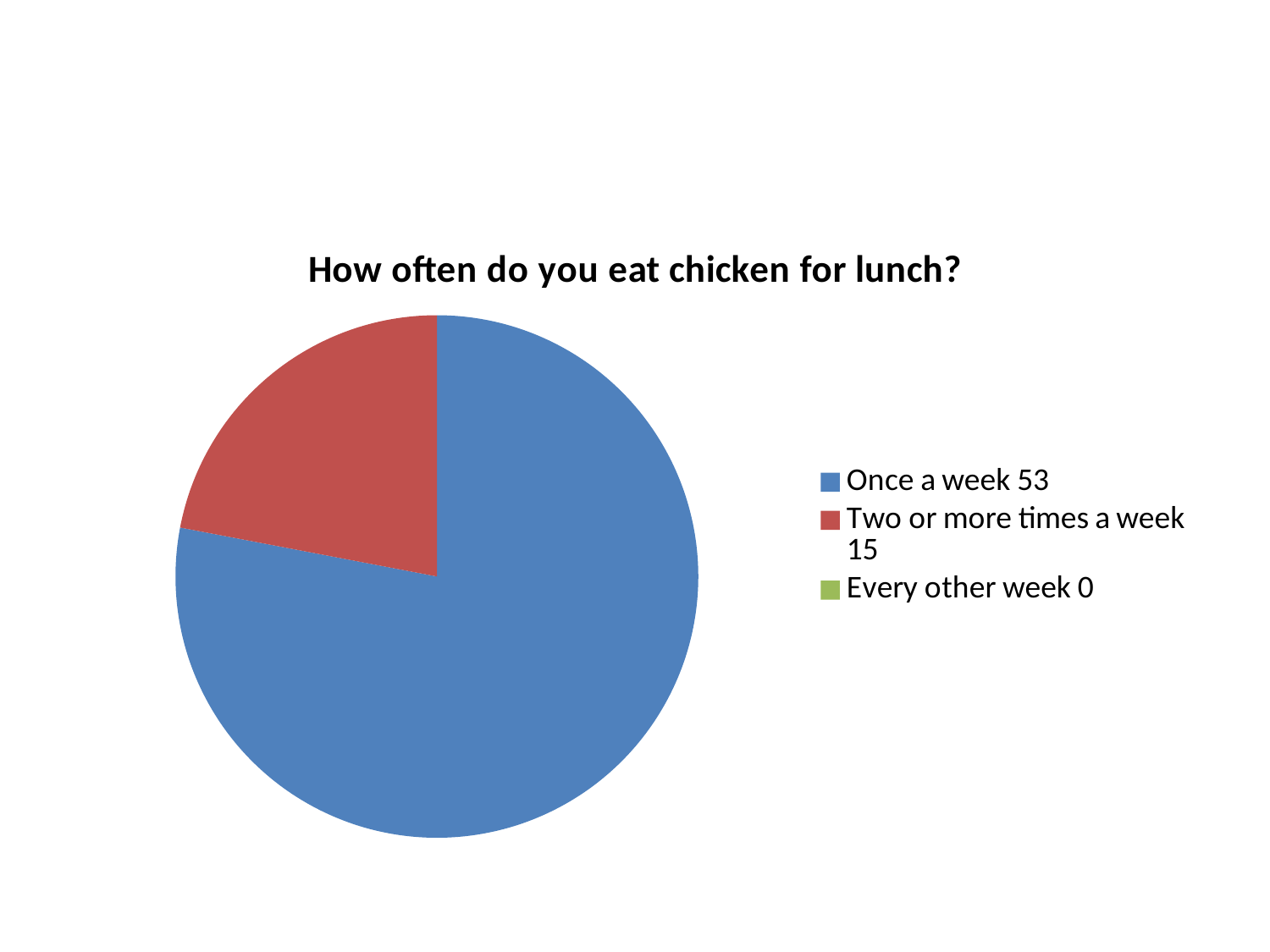
What type of chart is shown on the slide? pie chart Which is larger, the value for "Two or more times a week" or the value for "Every other week"? Two or more times a week What is the title of the chart? How often do you eat chicken for lunch? What is the value for "Every other week"? 0 Which category has the lowest value? Every other week How many categories does the legend list? 3 Which category has the highest value? Once a week What is the difference between the values for "Once a week" and "Two or more times a week"? 38 What is the value for "Once a week"? 53 What is the value for "Two or more times a week"? 15 What is the total of all the values shown in the legend? 68 What colour is the slice for "Once a week"? blue